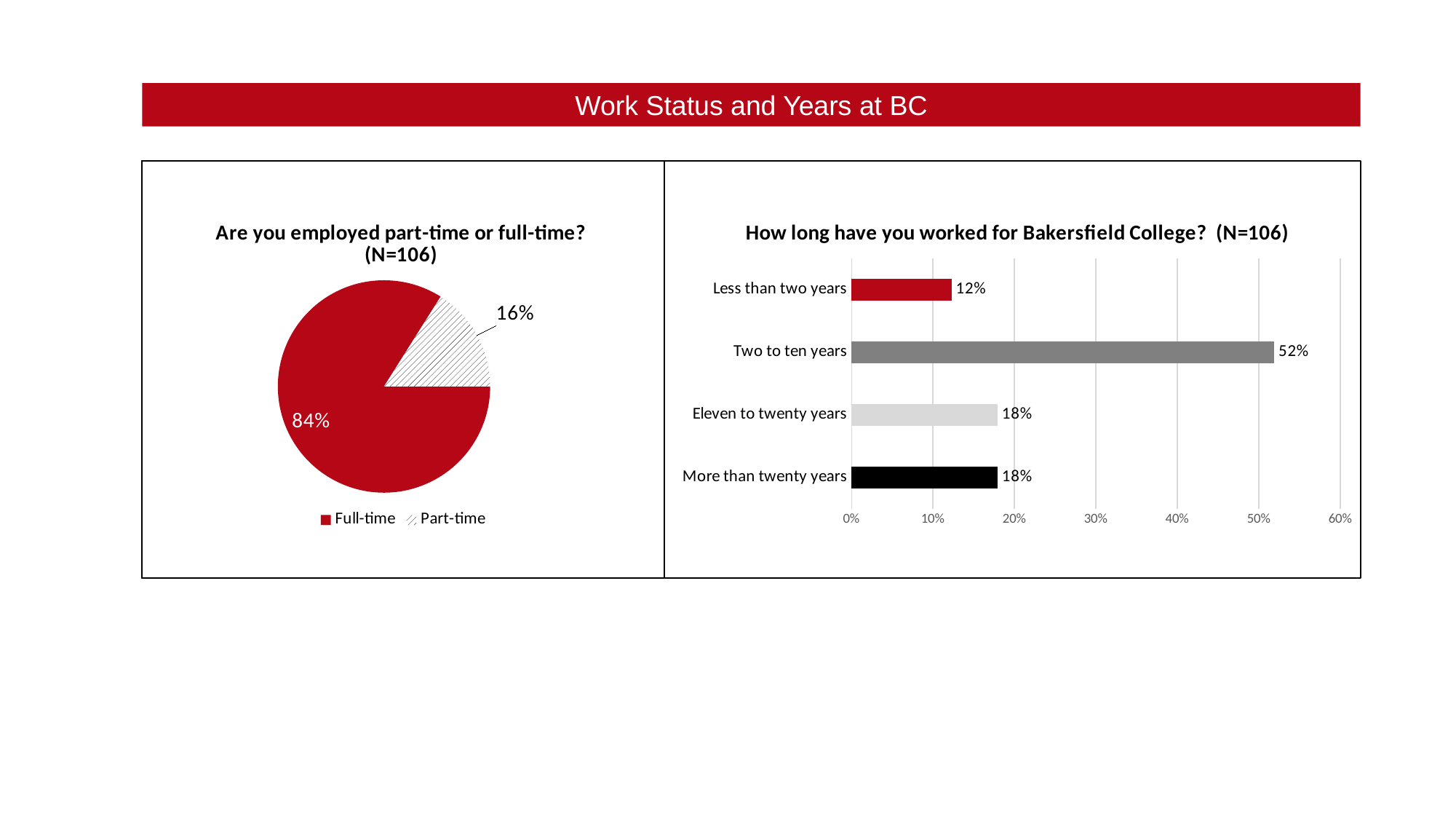
In the chart 'How long have you worked for Bakersfield College?', how many categories are shown? 4 In the pie chart 'Are you employed part-time or full-time?', which category has the larger slice? Full-time What type of chart is the left chart, 'Are you employed part-time or full-time?'? Pie chart In the pie chart 'Are you employed part-time or full-time?', what share of respondents are Full-time? 84% In the chart 'How long have you worked for Bakersfield College?', what is the difference between Two to ten years and Eleven to twenty years? 34% What type of chart is the right chart, 'How long have you worked for Bakersfield College?'? Bar chart In the pie chart 'Are you employed part-time or full-time?', how many entries does the legend list? 2 In the chart 'How long have you worked for Bakersfield College?', which category has the highest value? Two to ten years In the chart 'How long have you worked for Bakersfield College?', what is the value for Less than two years? 12% In the chart 'How long have you worked for Bakersfield College?', what is the value for Two to ten years? 52% In the pie chart 'Are you employed part-time or full-time?', what share of respondents are Part-time? 16% In the chart 'How long have you worked for Bakersfield College?', which category has the lowest value? Less than two years